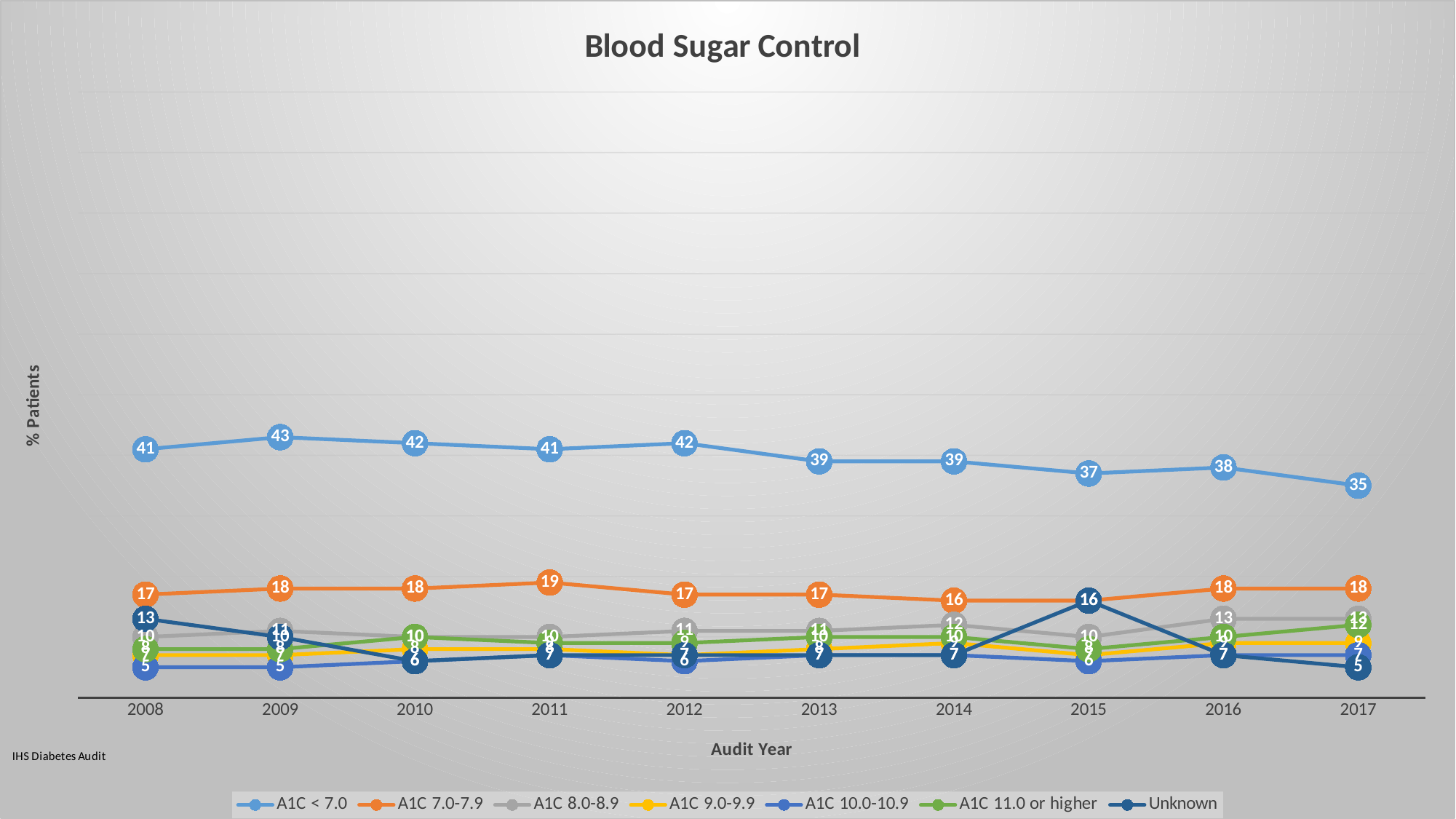
How many series does the legend list? 7 What is the value for A1C 7.0-7.9 in 2011? 19 In which year is the A1C < 7.0 series lowest? 2017 How many audit years are plotted along the x axis? 10 What is the value for A1C < 7.0 in 2008? 41 What kind of chart is shown on the slide? line chart What is the value for Unknown in 2015? 16 What is the title of the x axis? Audit Year What is the value for A1C < 7.0 in 2017? 35 What is the difference between the A1C < 7.0 value in 2008 and in 2017? 6 Does the A1C < 7.0 series generally rise or fall from 2008 to 2017? fall In which year is the A1C < 7.0 series highest? 2009